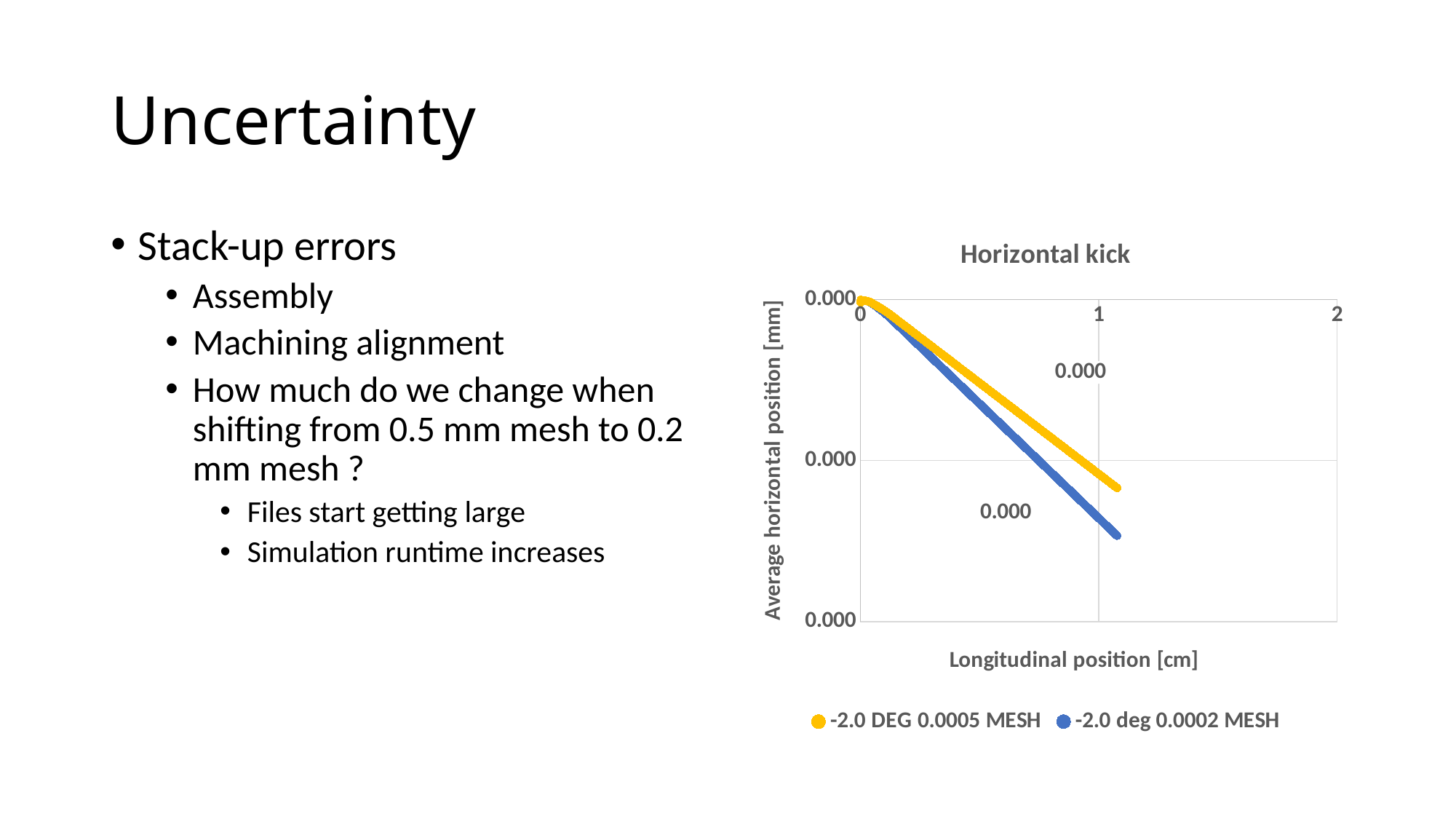
What kind of chart is the "Horizontal kick" chart? scatter chart What is the y-axis label of the "Horizontal kick" chart? Average horizontal position [mm] What is the x-axis label of the "Horizontal kick" chart? Longitudinal position [cm] How many series does the legend of the "Horizontal kick" chart list? 2 In the "Horizontal kick" chart, which series has the lower average horizontal position at the right end of the plotted data? -2.0 deg 0.0002 MESH What are the two series named in the legend of the "Horizontal kick" chart? -2.0 DEG 0.0005 MESH and -2.0 deg 0.0002 MESH In the "Horizontal kick" chart, do the values of the -2.0 deg 0.0002 MESH series rise or fall as longitudinal position increases? fall In the "Horizontal kick" chart, do the values of the -2.0 DEG 0.0005 MESH series rise or fall as longitudinal position increases? fall In the "Horizontal kick" chart, which series declines more steeply with longitudinal position? -2.0 deg 0.0002 MESH